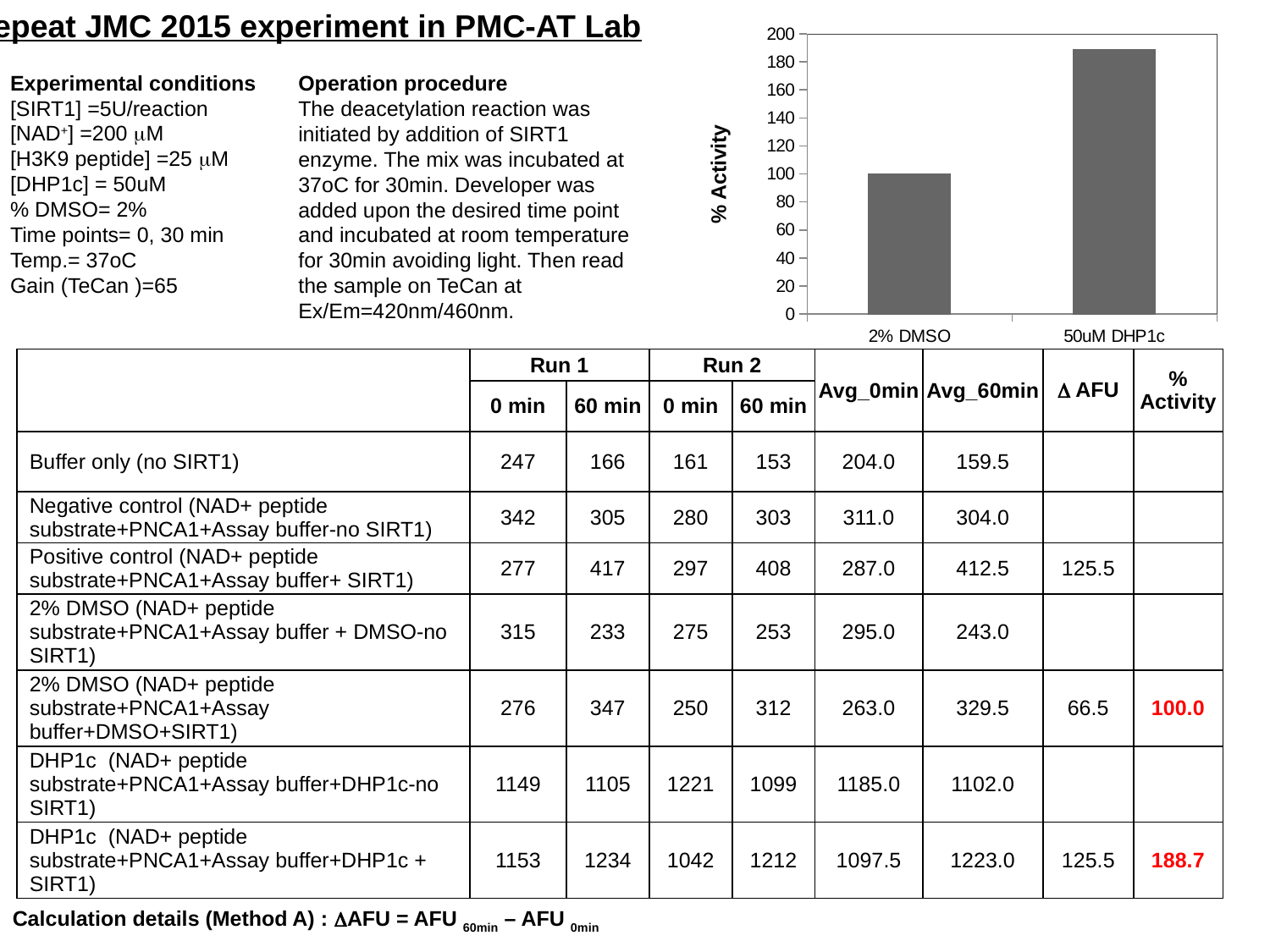
Is the % Activity value for 2% DMSO greater or less than 120? less How many categories are plotted on the bar chart? 2 Which category has the highest % Activity in the bar chart? 50uM DHP1c Do the bar values rise or fall from left to right across the x axis? rise Is the % Activity value for 50uM DHP1c greater or less than 180? greater Which has a larger % Activity, 2% DMSO or 50uM DHP1c? 50uM DHP1c What is the highest tick value shown on the vertical axis of the bar chart? 200 What kind of chart is shown on the slide? bar chart What is the label on the vertical axis of the bar chart? % Activity Is the % Activity value for 50uM DHP1c greater or less than 200? less What is the % Activity value for 2% DMSO in the bar chart? 100 Which category has the lowest % Activity in the bar chart? 2% DMSO